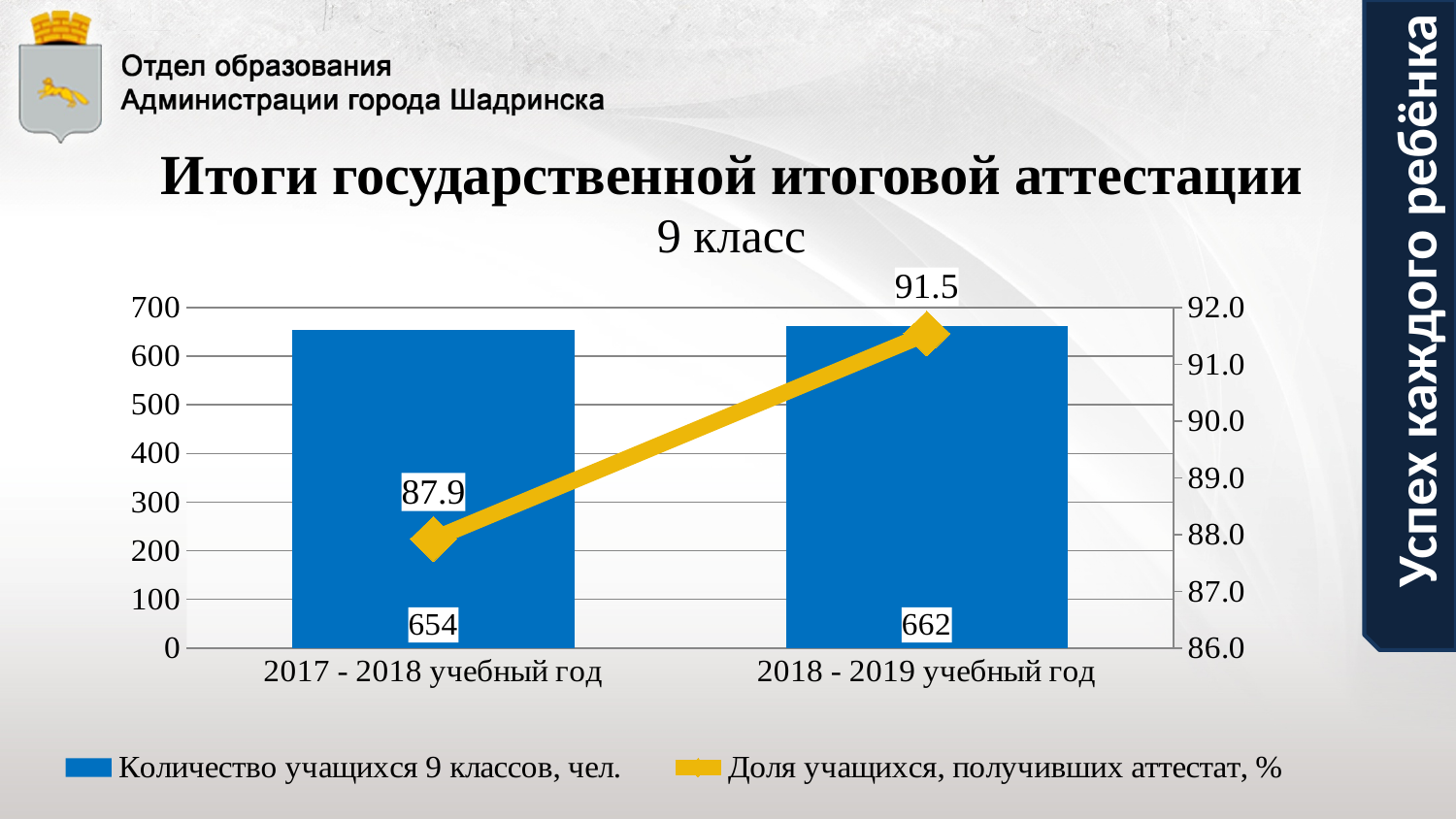
What is the number of 9th-grade students (Количество учащихся 9 классов, чел.) for 2018 - 2019 учебный год? 662 How many series does the legend list? 2 Which school year has the higher number of 9th-grade students? 2018 - 2019 учебный год What is the share of students who received a certificate (Доля учащихся, получивших аттестат, %) for 2017 - 2018 учебный год? 87.9 Is the share of students receiving a certificate higher in 2017 - 2018 or in 2018 - 2019? 2018 - 2019 учебный год By how many percentage points did the share of students receiving a certificate change from 2017 - 2018 to 2018 - 2019? 3.6 What is the number of 9th-grade students (Количество учащихся 9 классов, чел.) for 2017 - 2018 учебный год? 654 Does the share of students receiving a certificate rise or fall from 2017 - 2018 to 2018 - 2019? rise What is the share of students who received a certificate (Доля учащихся, получивших аттестат, %) for 2018 - 2019 учебный год? 91.5 Which school year has the lower share of students who received a certificate? 2017 - 2018 учебный год By how much did the number of 9th-grade students increase from 2017 - 2018 to 2018 - 2019? 8 How many school years are shown on the x axis of the chart? 2